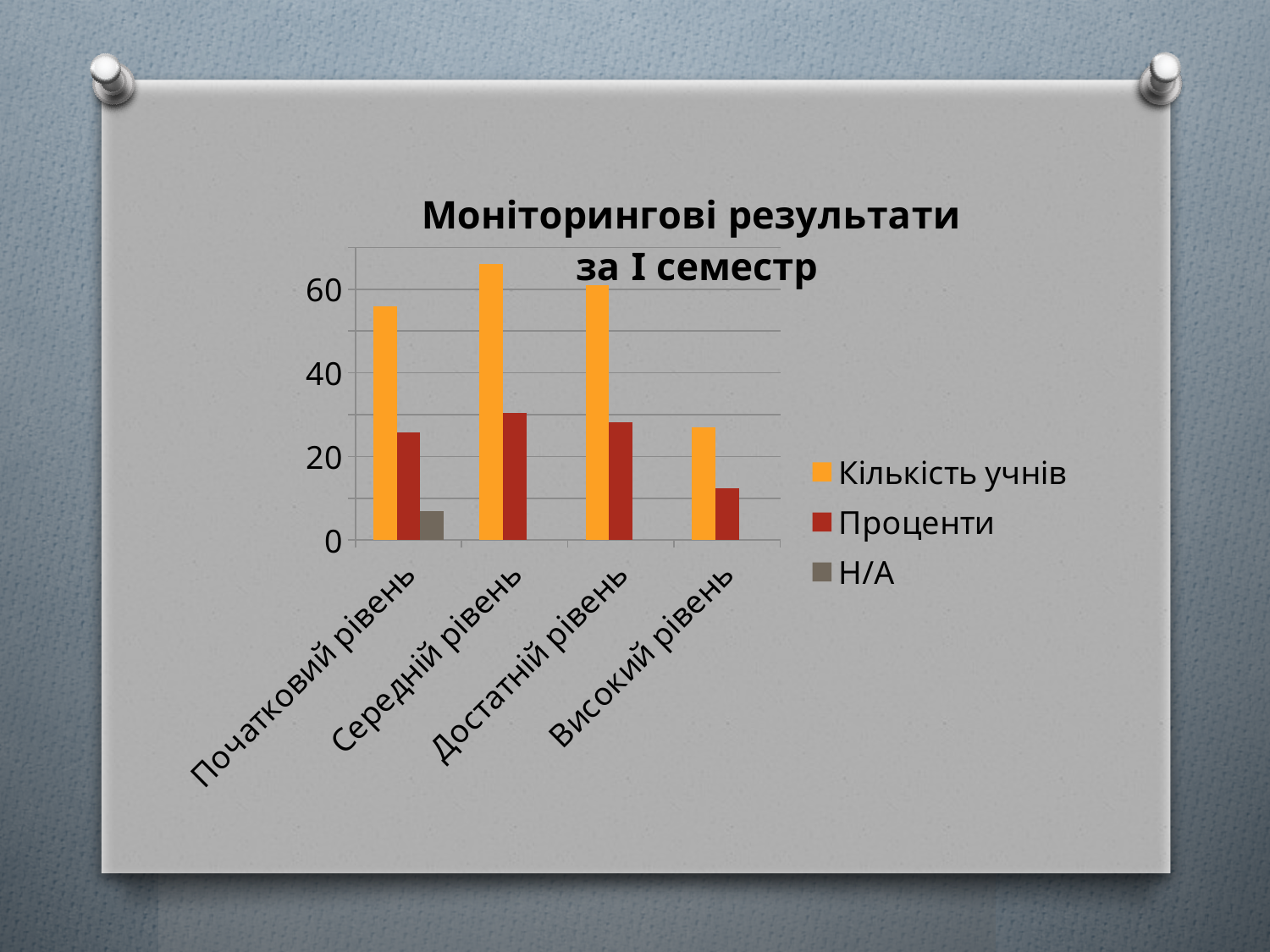
Is the value for Кількість учнів at Середній рівень greater or less than 60? greater Which category has the highest value for Кількість учнів? Середній рівень Which is larger: Кількість учнів at Достатній рівень or Кількість учнів at Високий рівень? Достатній рівень Is the value for Проценти at Початковий рівень greater or less than 20? greater How many categories are shown on the x axis of the chart? 4 Is the value for Кількість учнів at Високий рівень greater or less than 40? less Which category has the lowest value for Проценти? Високий рівень What kind of chart is shown on the slide? bar chart Which series is shown in orange in the chart legend? Кількість учнів What is the title of the chart? Моніторингові результати за І семестр Which category has the lowest value for Кількість учнів? Високий рівень How many series does the chart legend list? 3